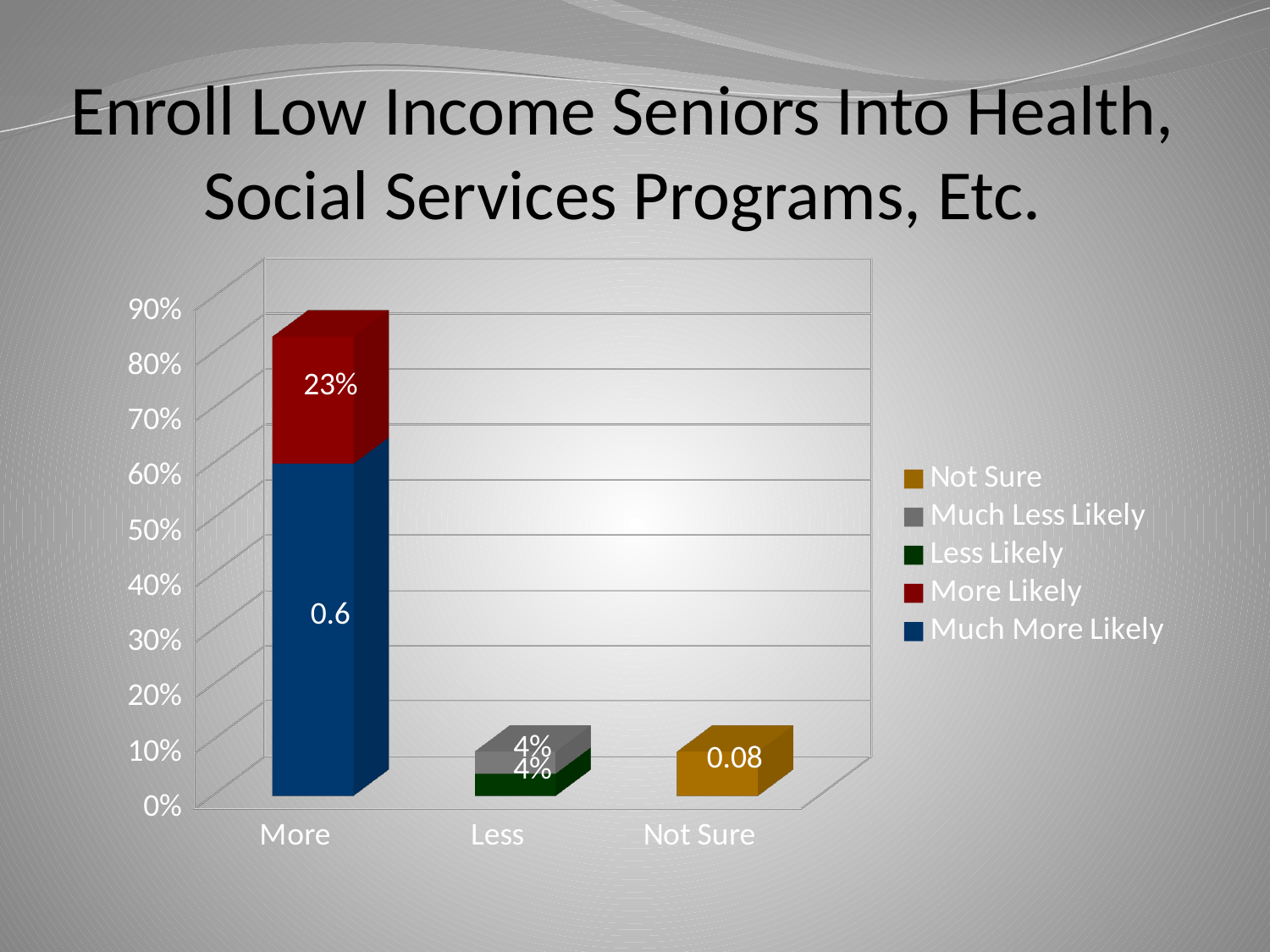
What is the value of the Not Sure bar? 0.08 What is the value of the More Likely segment for the More category? 23% In the More bar, which segment is larger: Much More Likely or More Likely? Much More Likely What is the value of the Less Likely segment for the Less category? 4% Is the value of the Not Sure bar greater or less than 10%? less What is the value of the Much More Likely segment for the More category? 0.6 How many categories are shown on the x axis? 3 How many series does the legend list? 5 Which category has the tallest stacked bar? More What is the total of the stacked bar for the Less category? 8% What kind of chart is shown on the slide? Stacked bar chart Is the total value of the More bar greater or less than 70%? greater